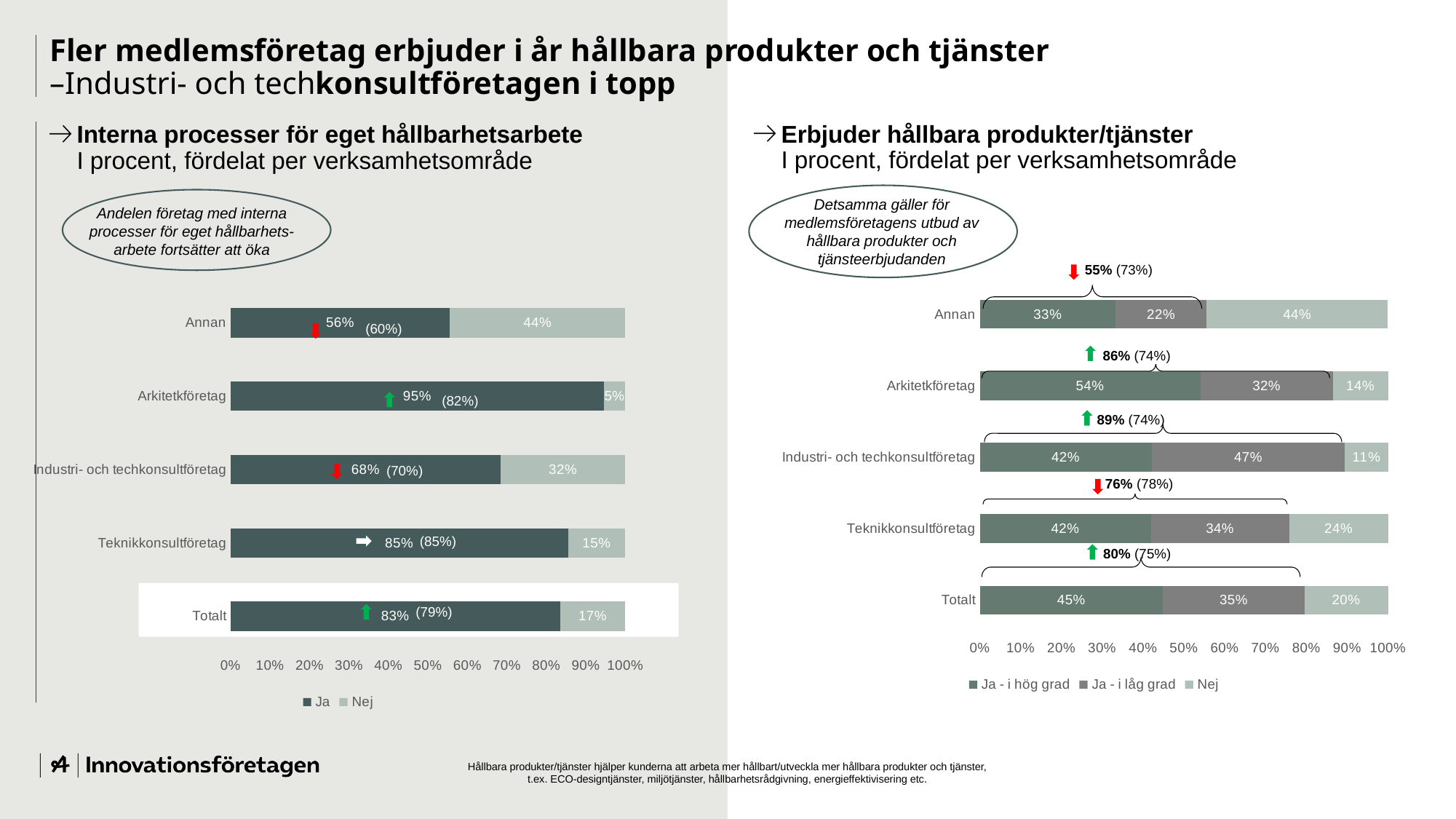
In the chart 'Erbjuder hållbara produkter/tjänster', what is the combined 'Ja' share (hög grad plus låg grad) for Totalt? 80% In the chart 'Erbjuder hållbara produkter/tjänster', is the 'Nej' value for Teknikkonsultföretag larger or smaller than the 'Nej' value for Arkitektföretag? larger In the chart 'Erbjuder hållbara produkter/tjänster', what is the 'Ja - i hög grad' value for Arkitektföretag? 54% In the chart 'Interna processer för eget hållbarhetsarbete', what is the 'Ja' value for Arkitektföretag? 95% In the chart 'Interna processer för eget hållbarhetsarbete', which category has the lowest 'Ja' value? Annan In the chart 'Erbjuder hållbara produkter/tjänster', what is the 'Ja - i låg grad' value for Industri- och techkonsultföretag? 47% In the chart 'Interna processer för eget hållbarhetsarbete', what is the difference between the 'Ja' values for Teknikkonsultföretag and Industri- och techkonsultföretag? 17 percentage points What type of chart is 'Erbjuder hållbara produkter/tjänster'? Stacked bar chart In the chart 'Interna processer för eget hållbarhetsarbete', what is the 'Nej' value for Industri- och techkonsultföretag? 32% In the chart 'Interna processer för eget hållbarhetsarbete', how many series does the legend list? 2 In the chart 'Erbjuder hållbara produkter/tjänster', how many categories are shown? 5 In the chart 'Erbjuder hållbara produkter/tjänster', which category has the highest 'Nej' value? Annan